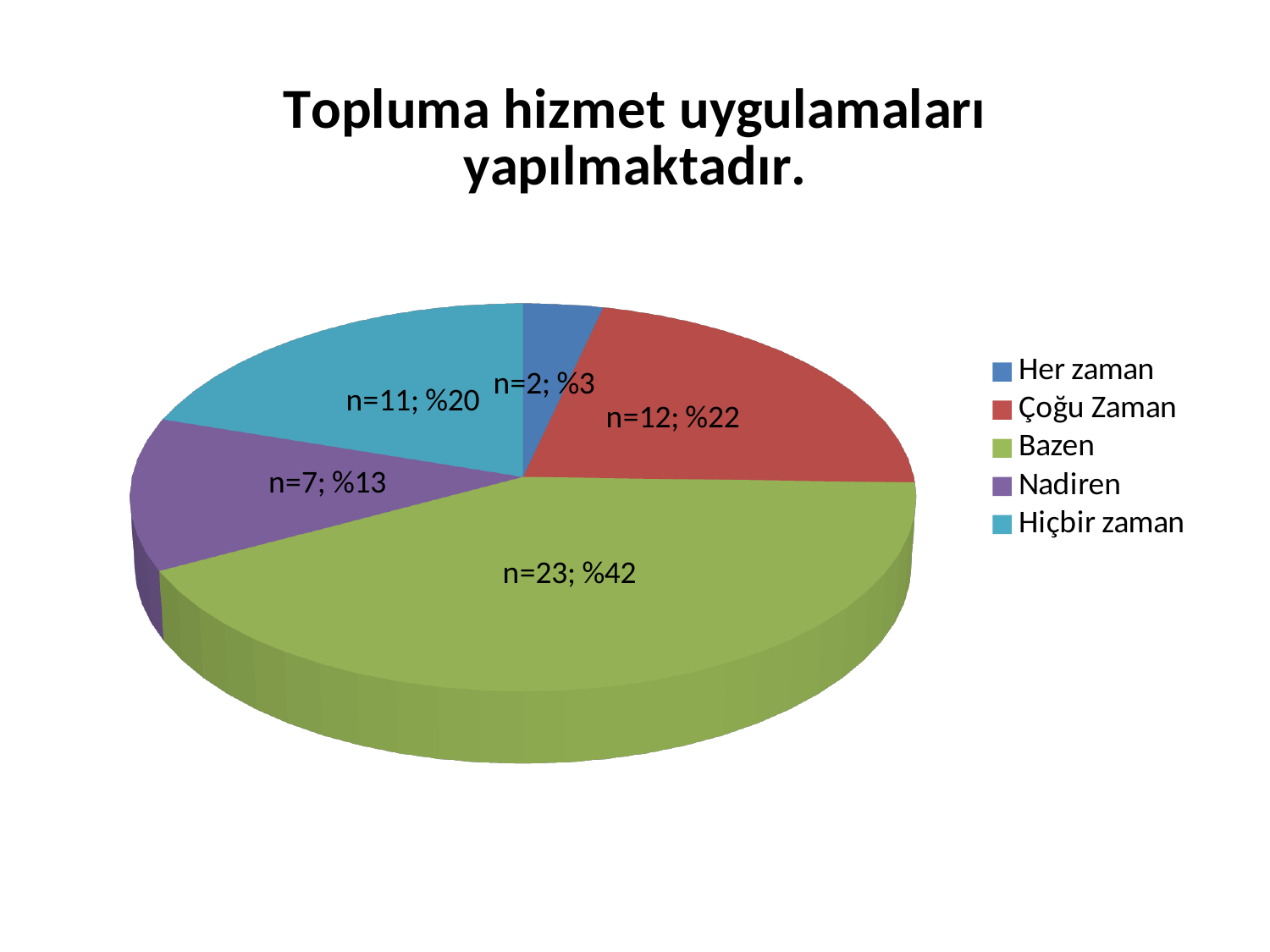
What is the title of the chart? Topluma hizmet uygulamaları yapılmaktadır. What is the difference in n between Bazen and Çoğu Zaman? 11 Which category has the largest slice? Bazen Which is larger, the Nadiren slice or the Hiçbir zaman slice? Hiçbir zaman What kind of chart is shown on the slide? pie chart What colour is the Nadiren slice? purple What percentage share does the Hiçbir zaman slice have? %20 What is the n value for Bazen? n=23 Which category has the smallest slice? Her zaman How many categories does the legend list? 5 What percentage share does the Bazen slice have? %42 What is the n value for Çoğu Zaman? n=12